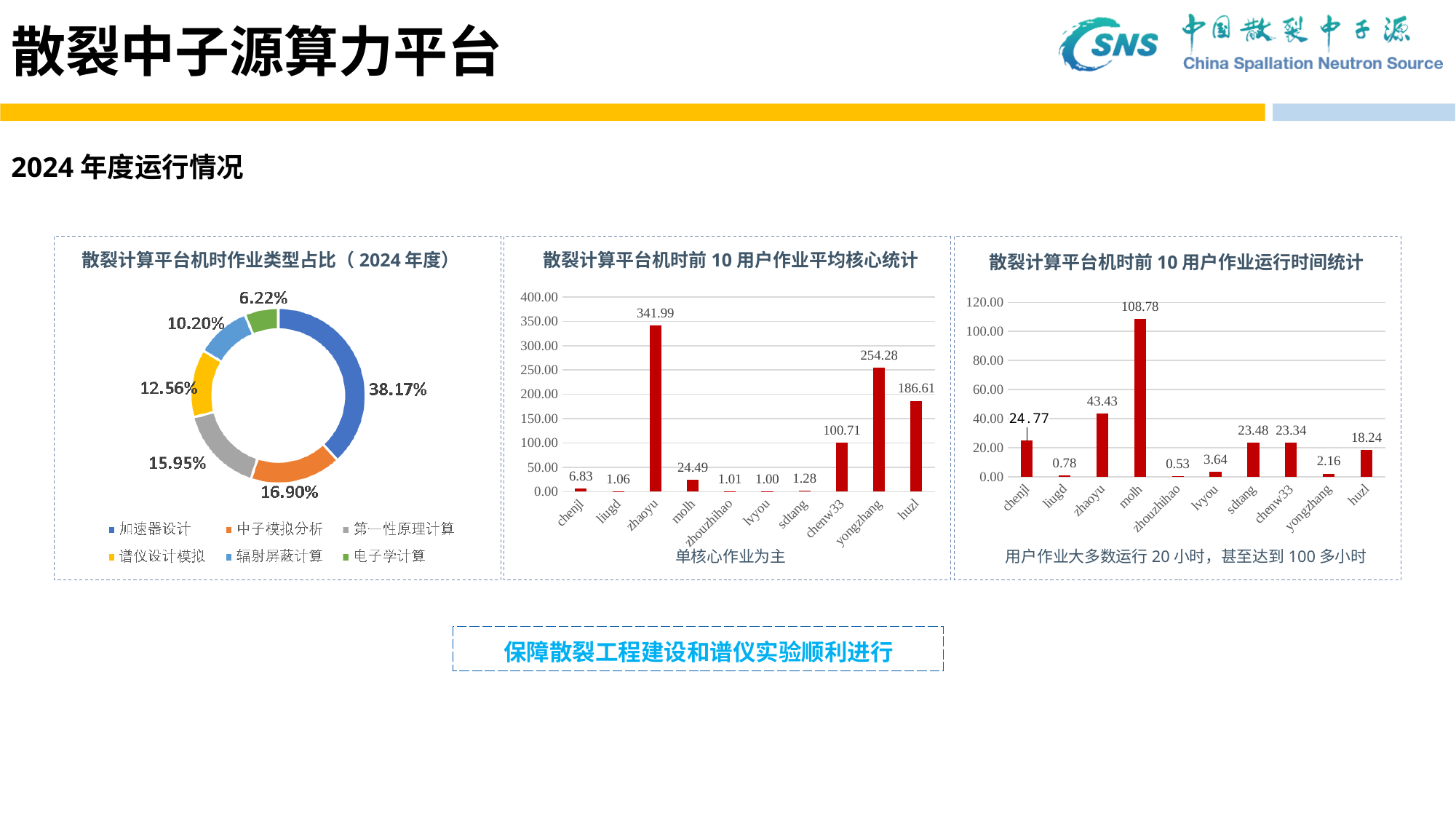
In the left chart (散裂计算平台机时作业类型占比), which category has the smallest share? 电子学计算 In the right chart (前10用户作业运行时间统计), what is the value for molh? 108.78 In the middle chart (前10用户作业平均核心统计), which user has the highest value? zhaoyu In the left chart (散裂计算平台机时作业类型占比), how many categories does the legend list? 6 In the middle chart (前10用户作业平均核心统计), what is the value for zhaoyu? 341.99 In the middle chart (前10用户作业平均核心统计), what is the difference between yongzhang and huzl? 67.67 In the right chart (前10用户作业运行时间统计), which user has the lowest value? zhouzhihao In the middle chart (前10用户作业平均核心统计), how many users are shown on the x axis? 10 What kind of chart is the right chart (前10用户作业运行时间统计)? Bar chart In the right chart (前10用户作业运行时间统计), which is larger, the value for chenjl or the value for zhaoyu? zhaoyu What kind of chart is the left chart (散裂计算平台机时作业类型占比)? Doughnut (pie) chart In the left chart (散裂计算平台机时作业类型占比), what share does 加速器设计 have? 38.17%